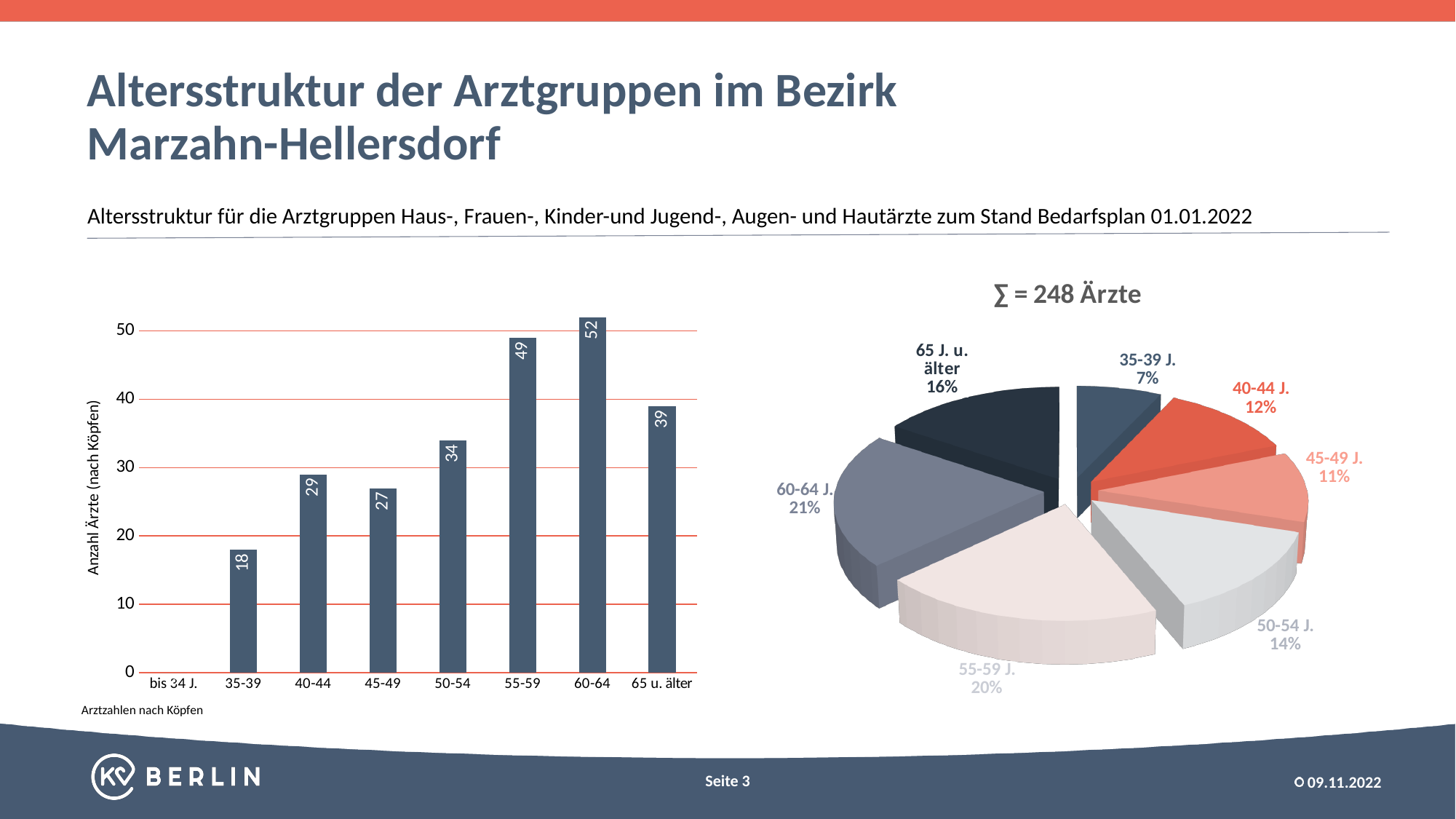
What total number of Ärzte is stated in the title of the pie chart on the right? 248 What is the y-axis label of the bar chart on the left? Anzahl Ärzte (nach Köpfen) In the bar chart on the left, which is larger: the value for 40-44 or the value for 45-49? 40-44 In the bar chart on the left, what is the value for the 35-39 age group? 18 How many slices does the pie chart on the right have? 7 In the bar chart on the left, how many Ärzte are in the 60-64 age group? 52 In the pie chart on the right, what share do the 60-64 J. Ärzte have? 21% In the bar chart on the left, what is the difference between the values for 55-59 and 50-54? 15 In the bar chart on the left, is the value for 65 u. älter greater or less than 40? less In the pie chart on the right, which age group has the smallest share? 35-39 J. What type of chart is shown on the left side of the slide? bar chart In the bar chart on the left, which age group has the highest number of Ärzte? 60-64